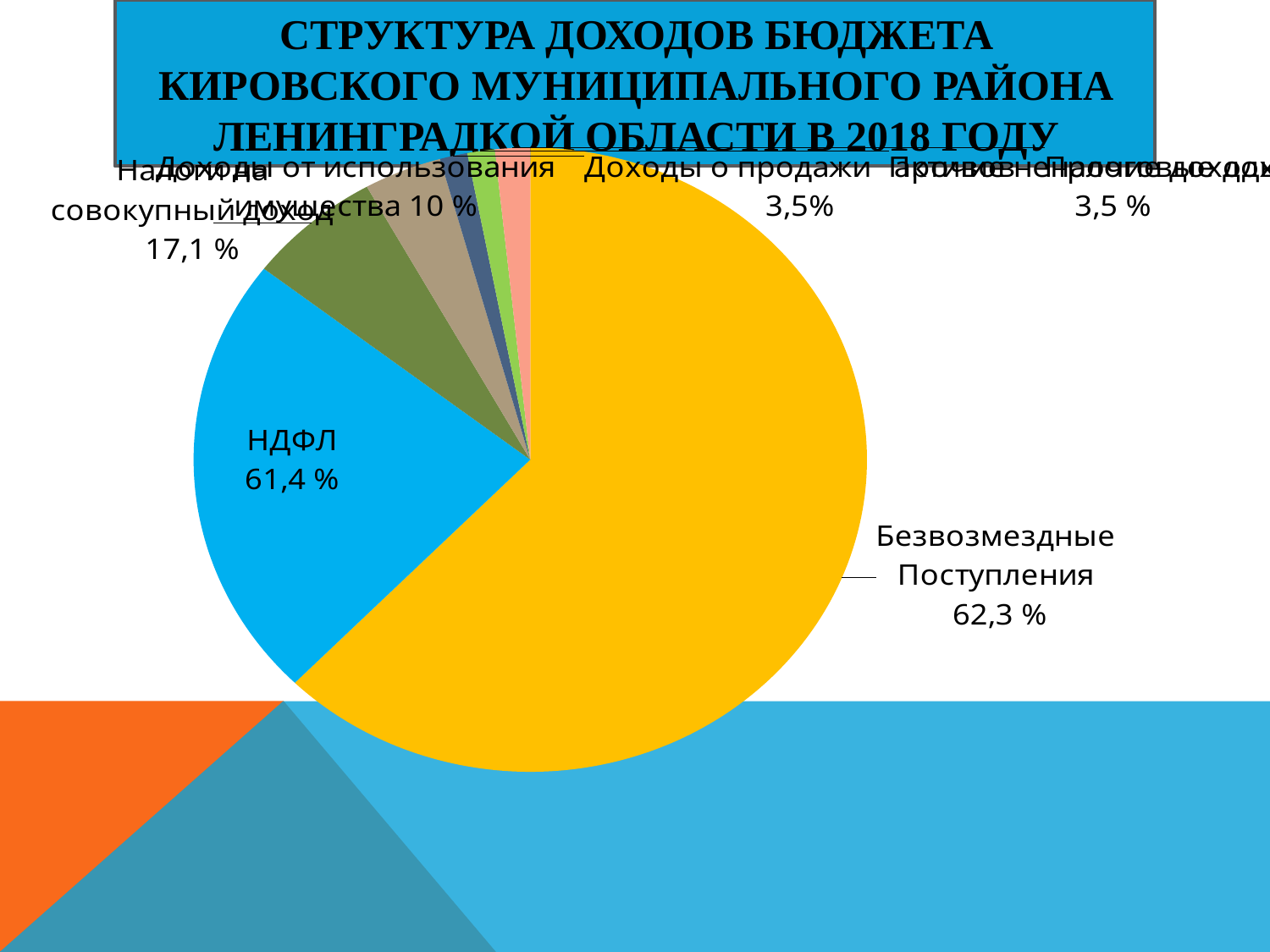
Which category has the largest slice of the pie? Безвозмездные Поступления How many slices does the pie chart have? 7 Which year does the chart title say the budget revenue structure refers to? 2018 Which is larger, the slice for НДФЛ or the slice for Налоги на совокупный доход? НДФЛ What kind of chart is shown on the slide? pie chart What value is shown for Налоги на совокупный доход? 17,1 % What value is shown for Доходы от использования имущества? 10 % What value is shown for Безвозмездные Поступления? 62,3 % What colour is the slice for НДФЛ? blue By how many percentage points does the НДФЛ value exceed the Налоги на совокупный доход value? 44,3 What share of budget revenue is labelled for НДФЛ? 61,4 %